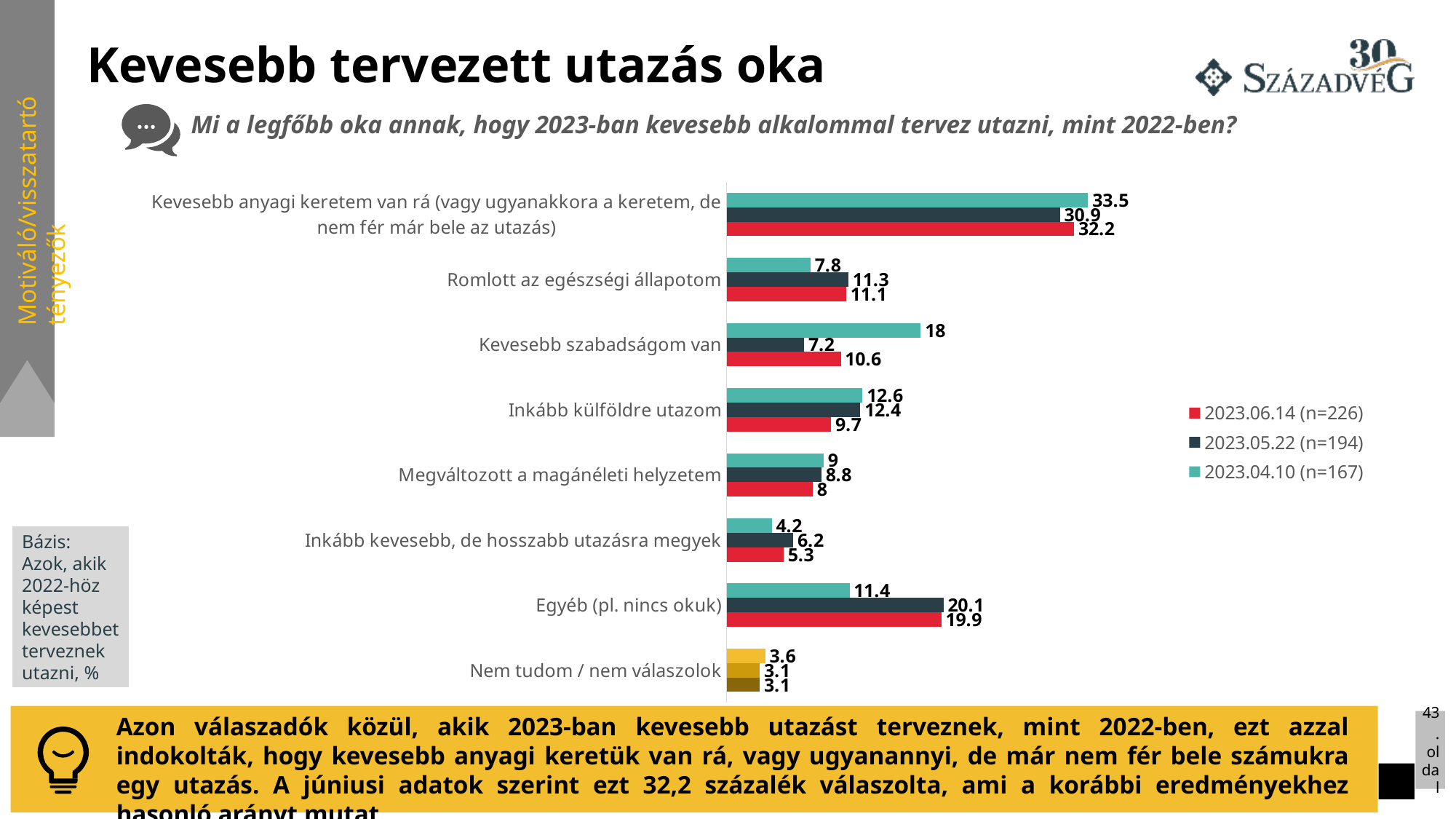
What is the value for 'Egyéb (pl. nincs okuk)' in the 2023.05.22 (n=194) series? 20.1 What is the difference between the 2023.04.10 (n=167) and 2023.05.22 (n=194) values for 'Kevesebb szabadságom van'? 10.8 Which category has the highest value in the 2023.06.14 (n=226) series? Kevesebb anyagi keretem van rá (vagy ugyanakkora a keretem, de nem fér már bele az utazás) How many series does the legend list? 3 What is the value for 'Kevesebb anyagi keretem van rá' in the 2023.06.14 (n=226) series? 32.2 Which category has the lowest value in the 2023.04.10 (n=167) series? Nem tudom / nem válaszolok Which series is shown in red in the legend? 2023.06.14 (n=226) For 'Romlott az egészségi állapotom', which is larger: the 2023.05.22 (n=194) value or the 2023.04.10 (n=167) value? 2023.05.22 (n=194) What is the difference between the 2023.06.14 (n=226) and 2023.05.22 (n=194) values for 'Kevesebb anyagi keretem van rá'? 1.3 How many categories are shown on the chart? 8 What kind of chart is shown on the slide? bar chart What is the value for 'Kevesebb szabadságom van' in the 2023.04.10 (n=167) series? 18